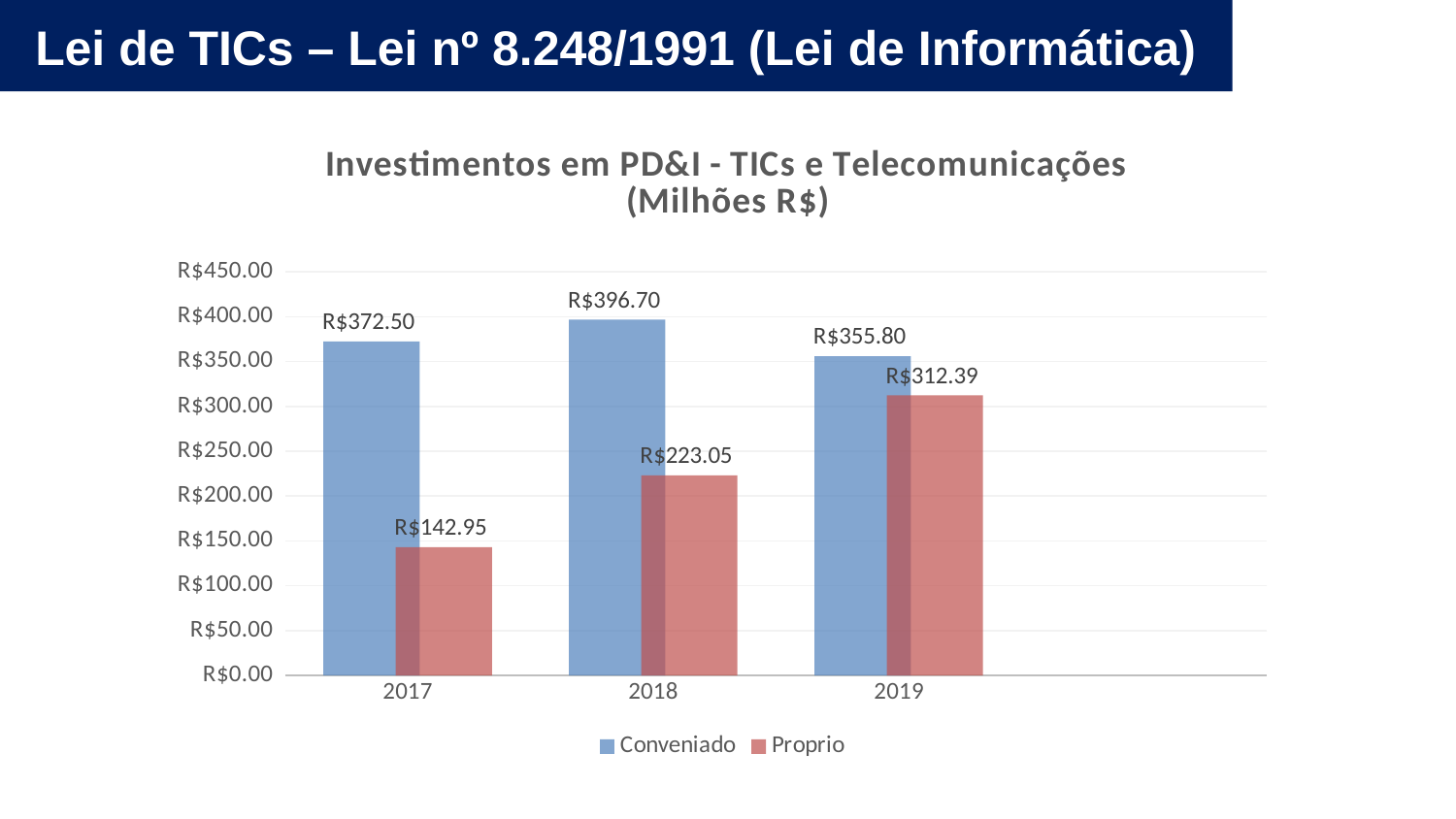
What is the Proprio value for 2017? R$142.95 Which year has the highest Conveniado value? 2018 What is the Proprio value for 2019? R$312.39 How many series does the legend list? 2 What is the title of the chart? Investimentos em PD&I - TICs e Telecomunicações (Milhões R$) What is the Conveniado value for 2018? R$396.70 Which is larger in 2018, Conveniado or Proprio? Conveniado How many years are shown on the x axis? 3 What is the difference between the Conveniado and Proprio values in 2019? R$43.41 What kind of chart is shown on the slide? Bar chart Do the Proprio values rise or fall from 2017 to 2019? Rise Which year has the lowest Proprio value? 2017